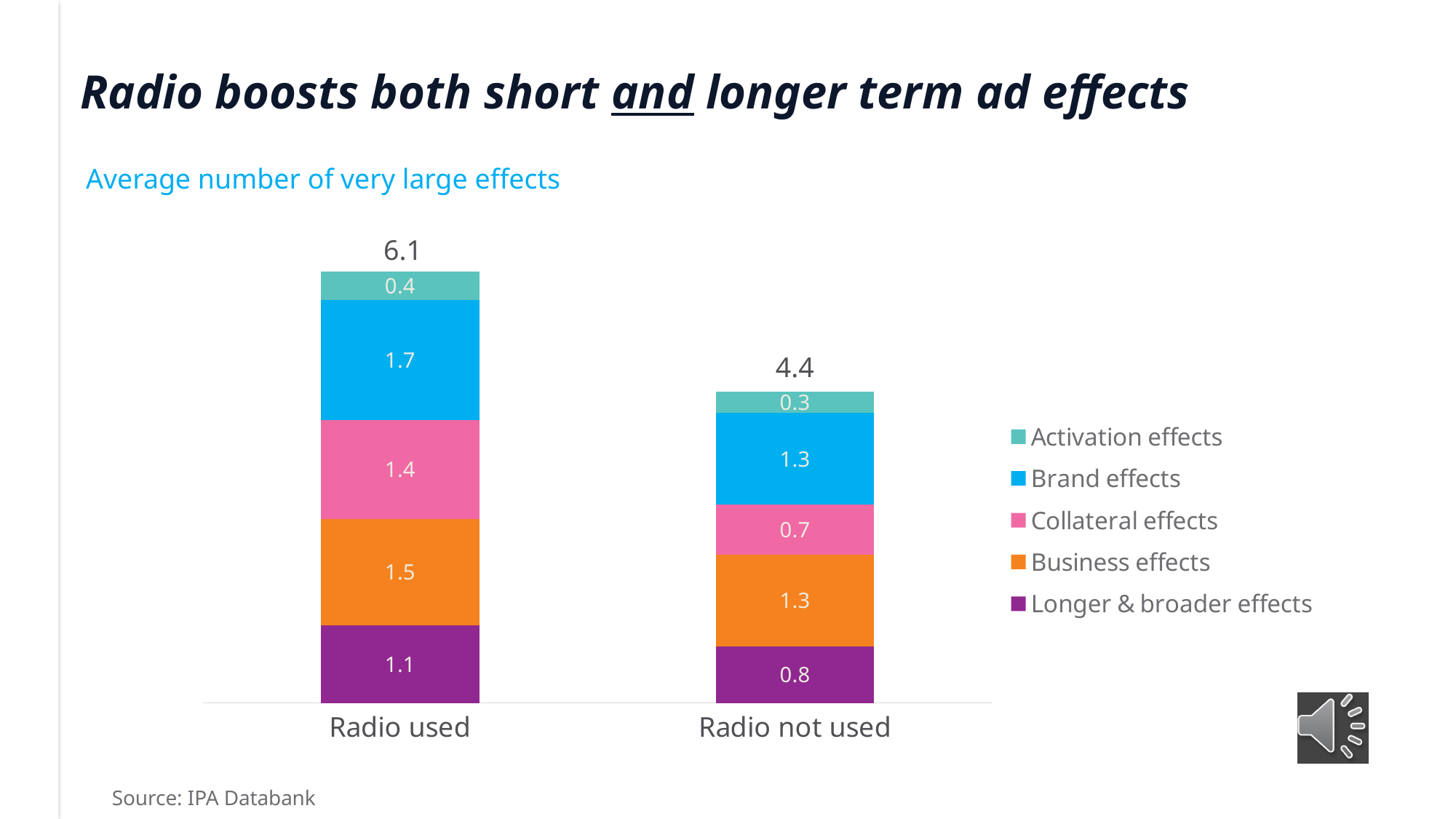
What is the value of Collateral effects for Radio not used? 0.7 How many series does the legend list? 5 Which series has the smallest value in the Radio used bar? Activation effects What is the value of Brand effects for Radio used? 1.7 What is the value of Longer & broader effects for Radio not used? 0.8 What is the difference in Collateral effects between Radio used and Radio not used? 0.7 What kind of chart is shown on the slide? Stacked bar chart How many categories are shown on the x axis? 2 Which category has the higher Business effects value, Radio used or Radio not used? Radio used What is the total of the stacked bar for Radio used? 6.1 What is the difference between the totals for Radio used and Radio not used? 1.7 What is the total of the stacked bar for Radio not used? 4.4